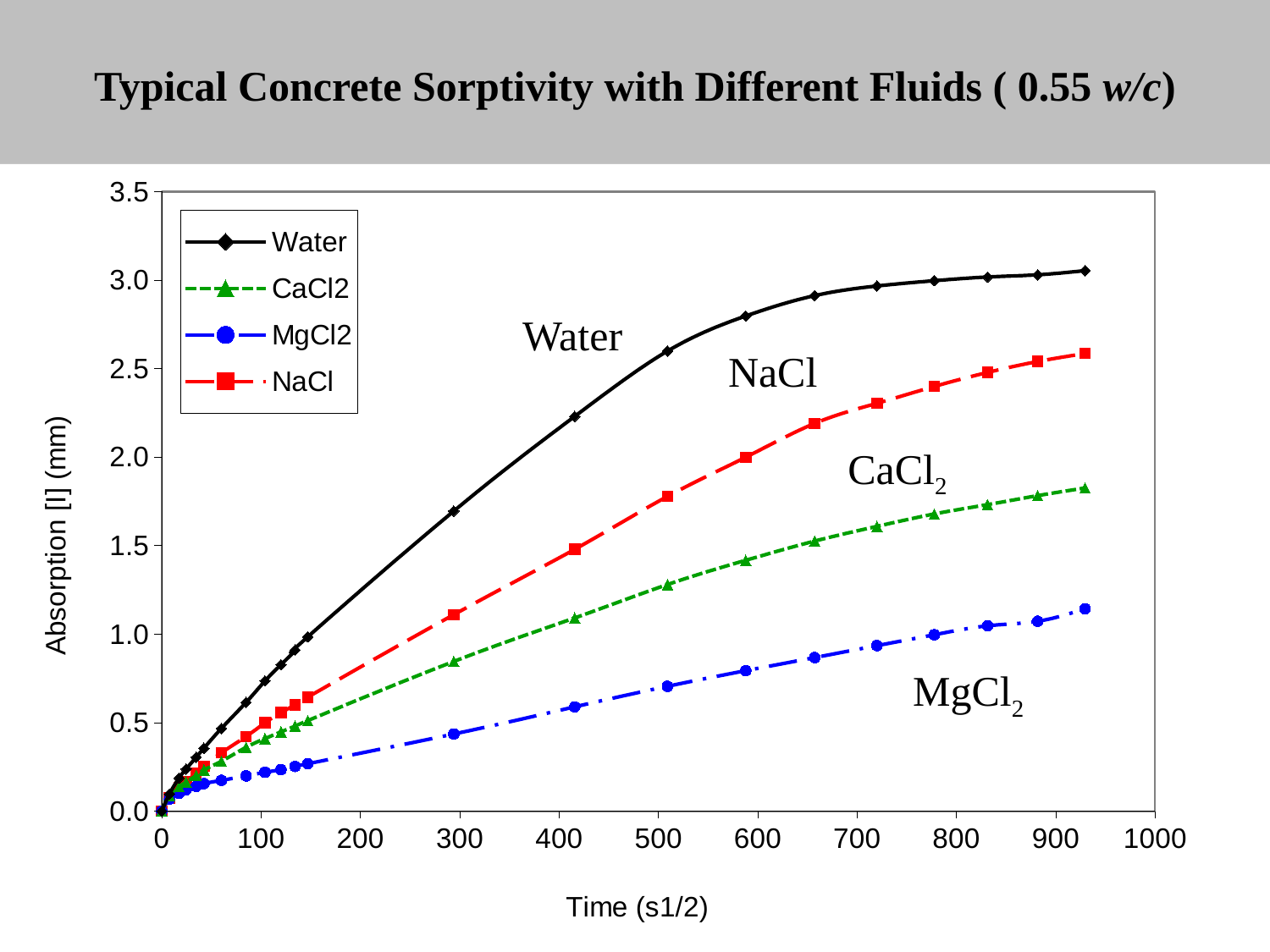
What kind of chart is shown on the slide? line chart Is the absorption for MgCl2 at about 930 s1/2 greater or less than 1.0 mm? greater Does the absorption for NaCl rise or fall as time increases? rises What is the title of the chart? Typical Concrete Sorptivity with Different Fluids ( 0.55 w/c) What is the label of the y axis? Absorption [I] (mm) Is the absorption for Water at about 500 s1/2 greater or less than 2.5 mm? greater At a time of about 900 s1/2, which has the higher absorption, CaCl2 or MgCl2? CaCl2 Is the absorption for CaCl2 at about 930 s1/2 greater or less than 2.0 mm? less Which fluid has the lowest absorption across the time range? MgCl2 How many series does the legend list? 4 Which fluid reaches the highest absorption at the end of the time range? Water At a time of about 600 s1/2, which has the higher absorption, Water or NaCl? Water